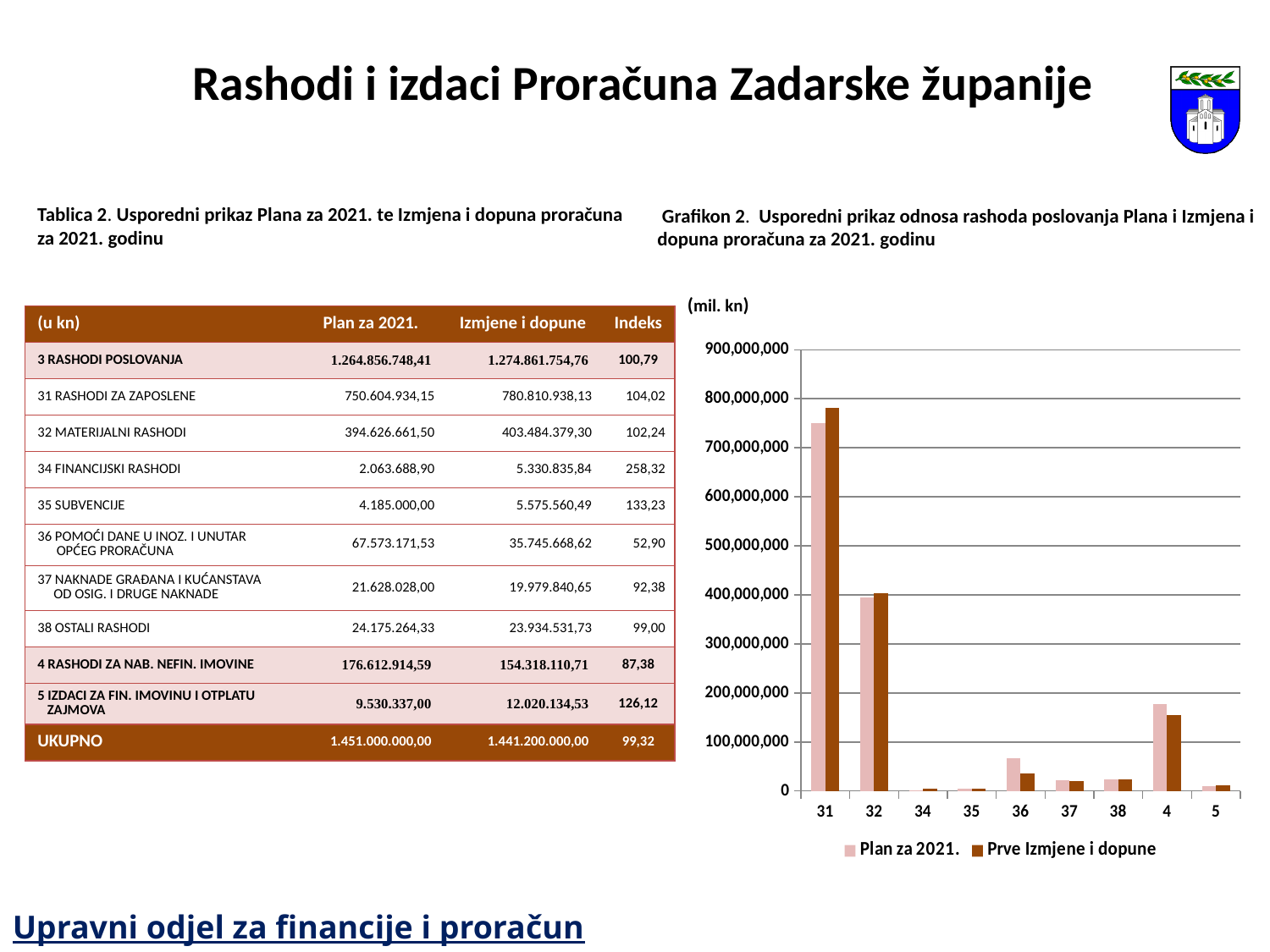
What are the two series names listed in the chart legend? Plan za 2021. and Prve Izmjene i dopune Is the Plan za 2021. value for category 32 greater or less than 500,000,000? less Which category has the highest bar for the Prve Izmjene i dopune series? 31 Is the Plan za 2021. value for category 31 greater or less than 700,000,000? greater For category 31, which series has the larger bar, Plan za 2021. or Prve Izmjene i dopune? Prve Izmjene i dopune For category 36, which series has the larger bar, Plan za 2021. or Prve Izmjene i dopune? Plan za 2021. How many categories are shown on the x axis of the chart? 9 Is the Prve Izmjene i dopune value for category 4 greater or less than 100,000,000? greater What kind of chart is Grafikon 2 on the slide? bar chart Which category has the highest bar for the Plan za 2021. series? 31 How many series does the chart legend list? 2